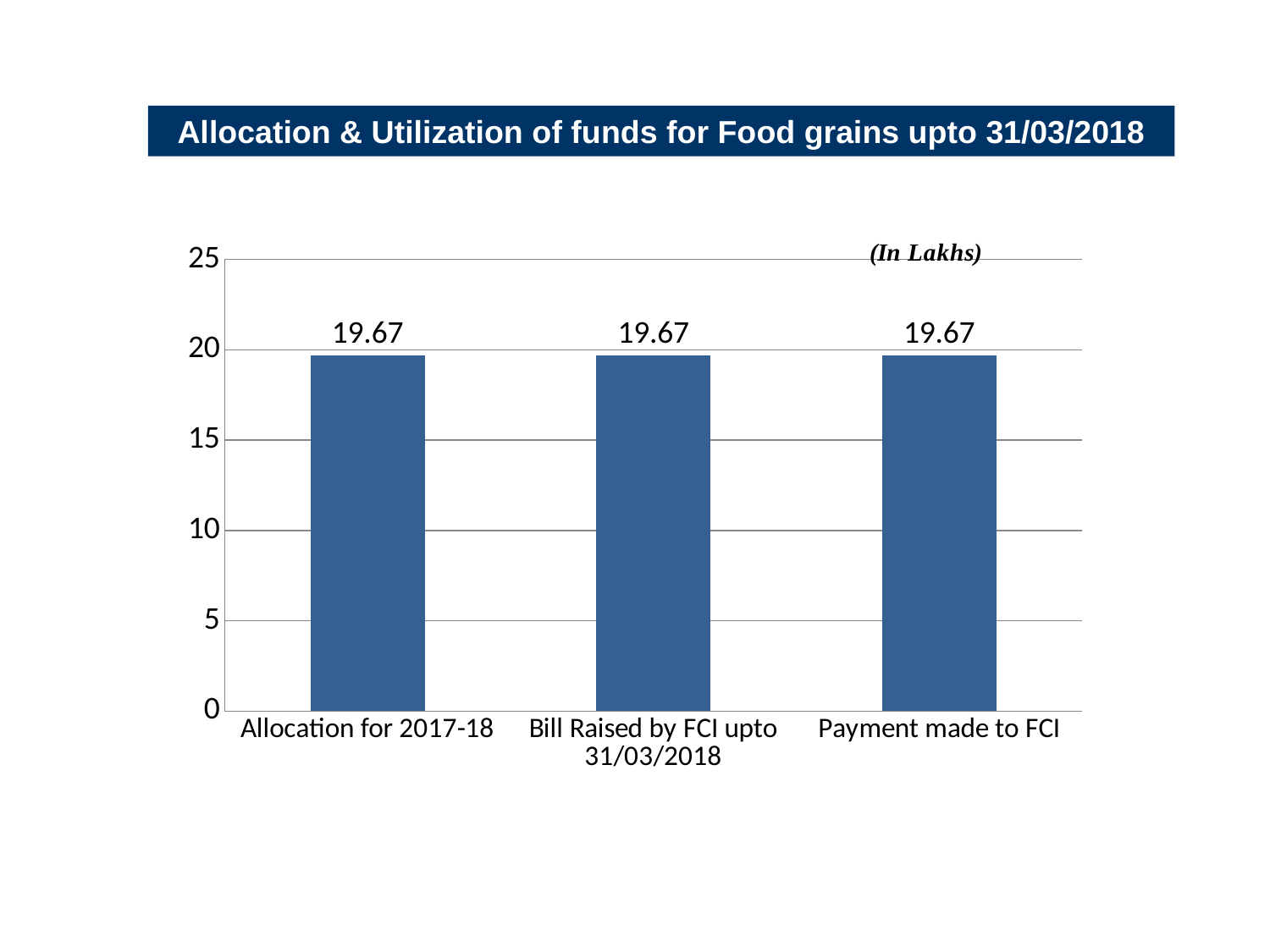
Is the value for Payment made to FCI greater or less than 15? greater Is the value for Allocation for 2017-18 greater or less than 20? less What is the value for Payment made to FCI? 19.67 What is the value for Bill Raised by FCI upto 31/03/2018? 19.67 In what units are the values on the chart expressed? Lakhs What kind of chart is shown on the slide? bar chart What is the title of the chart? Allocation & Utilization of funds for Food grains upto 31/03/2018 Do the values rise, fall, or stay the same across the categories from left to right? stay the same What is the value for Allocation for 2017-18? 19.67 What is the difference between the value for Allocation for 2017-18 and the value for Payment made to FCI? 0 How many categories are shown on the chart? 3